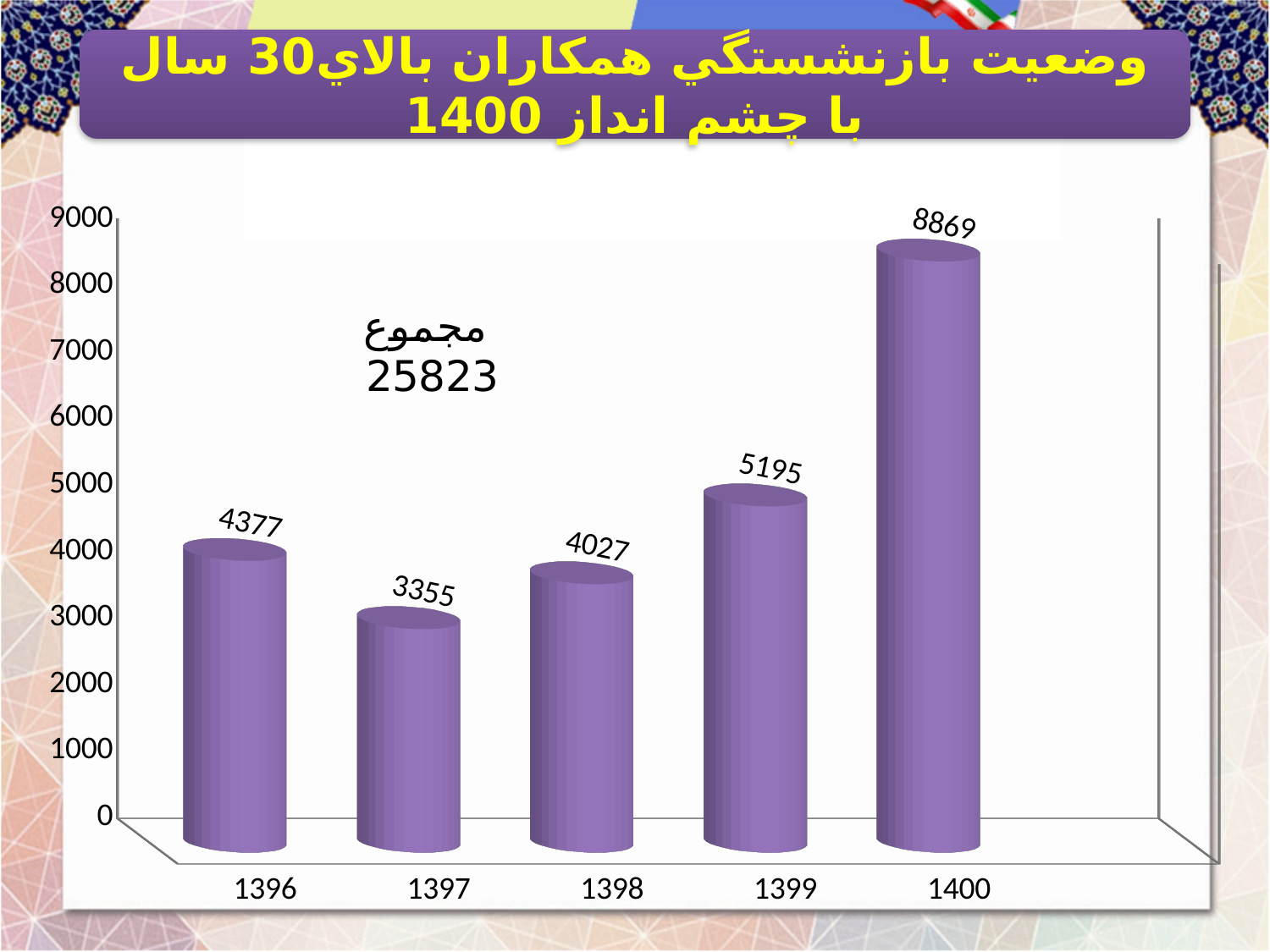
What is the difference between the values for 1400 and 1399? 3674 What kind of chart is shown on the slide? Bar chart What is the value for 1397? 3355 What is the value for 1399? 5195 What is the value for 1398? 4027 What is the value for 1396? 4377 What is the value for 1400? 8869 Which year has the lowest value? 1397 What total (مجموع) is printed on the chart? 25823 How many years are shown on the x axis? 5 Which year has the highest value? 1400 Which is larger, the value for 1396 or the value for 1398? 1396